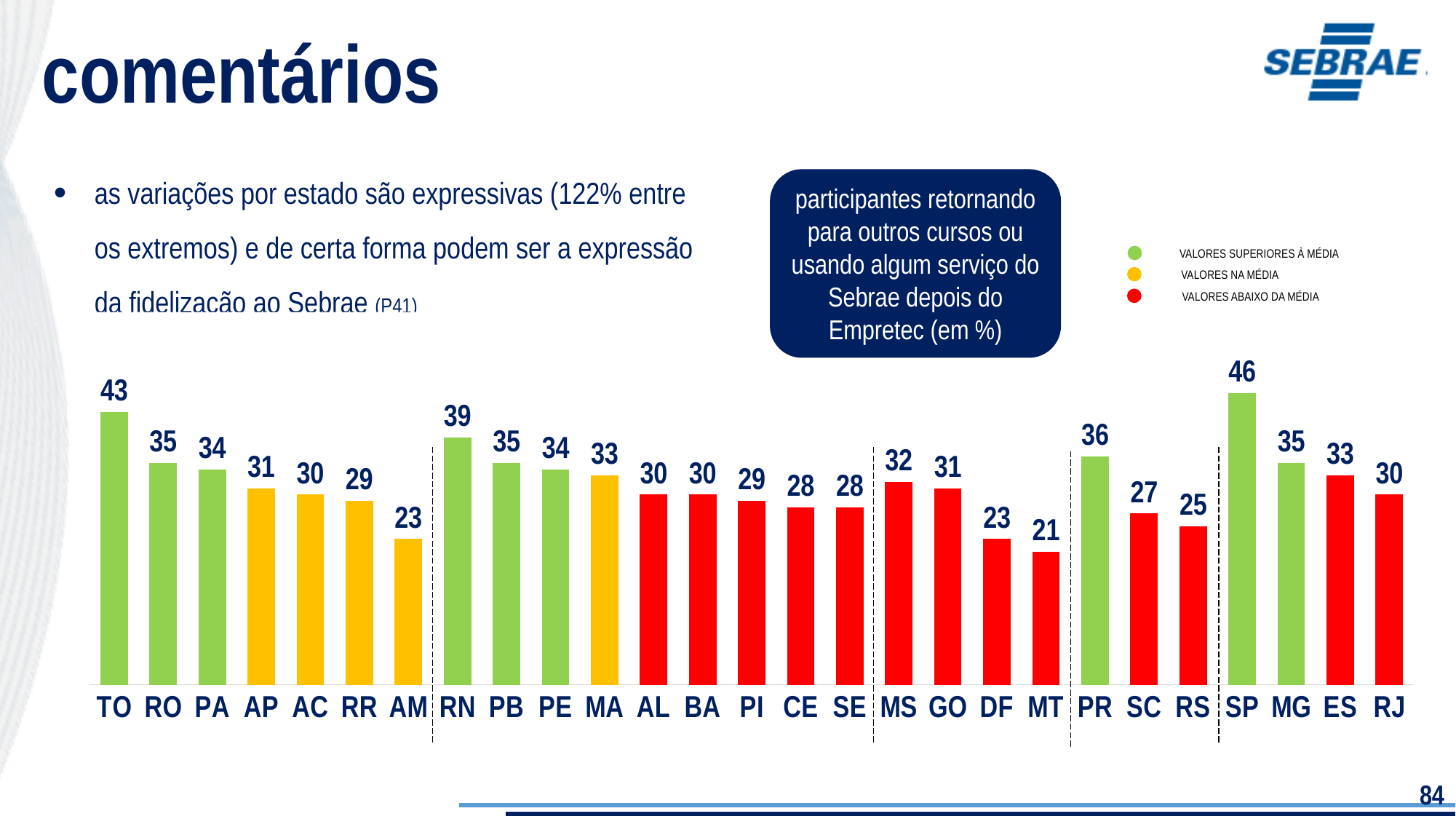
What colour are the bars for values below the average (valores abaixo da média)? red How many entries does the legend list? 3 What kind of chart is shown? bar chart What is the difference between the values for SP and MT? 25 What is the difference between the values for TO and AM? 20 What is the value for RN? 39 How many states are shown on the chart? 27 Which state has the highest value? SP Which is larger, the value for PR or the value for MS? PR What is the value for MT? 21 Which state has the lowest value? MT What is the value for SP? 46